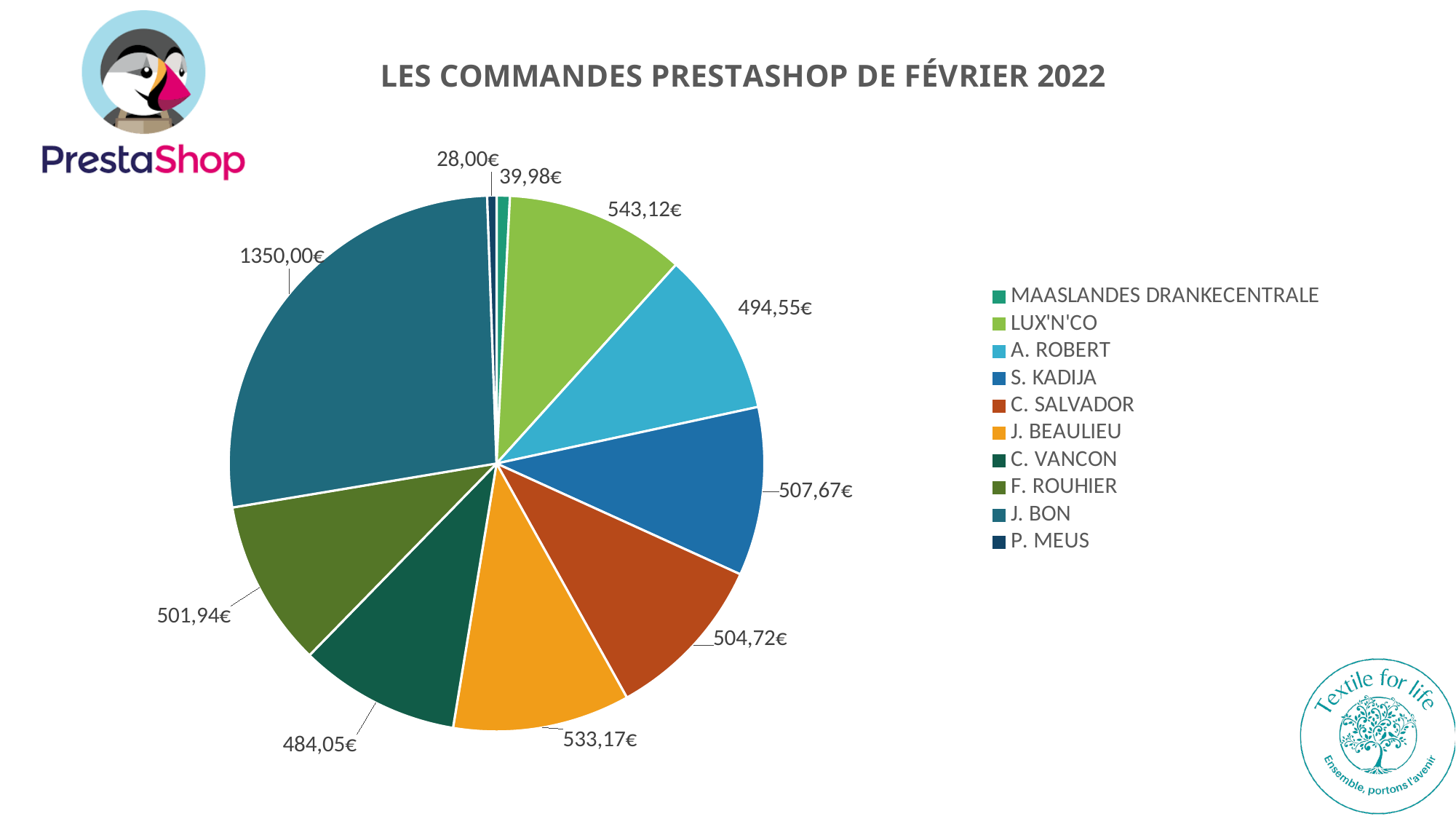
What type of chart is shown on the slide? Pie chart Which customer has the largest slice of the pie? J. BON What is the value for C. VANCON? 484,05€ What is the value for J. BON? 1350,00€ What is the title of the chart? LES COMMANDES PRESTASHOP DE FÉVRIER 2022 How many entries does the legend list? 10 Which customer has the smallest slice of the pie? P. MEUS What is the value for LUX'N'CO? 543,12€ What is the difference between the values for LUX'N'CO and A. ROBERT? 48,57€ Which is larger, the value for J. BEAULIEU or the value for C. VANCON? J. BEAULIEU What is the value for P. MEUS? 28,00€ What is the difference between the values for J. BON and F. ROUHIER? 848,06€